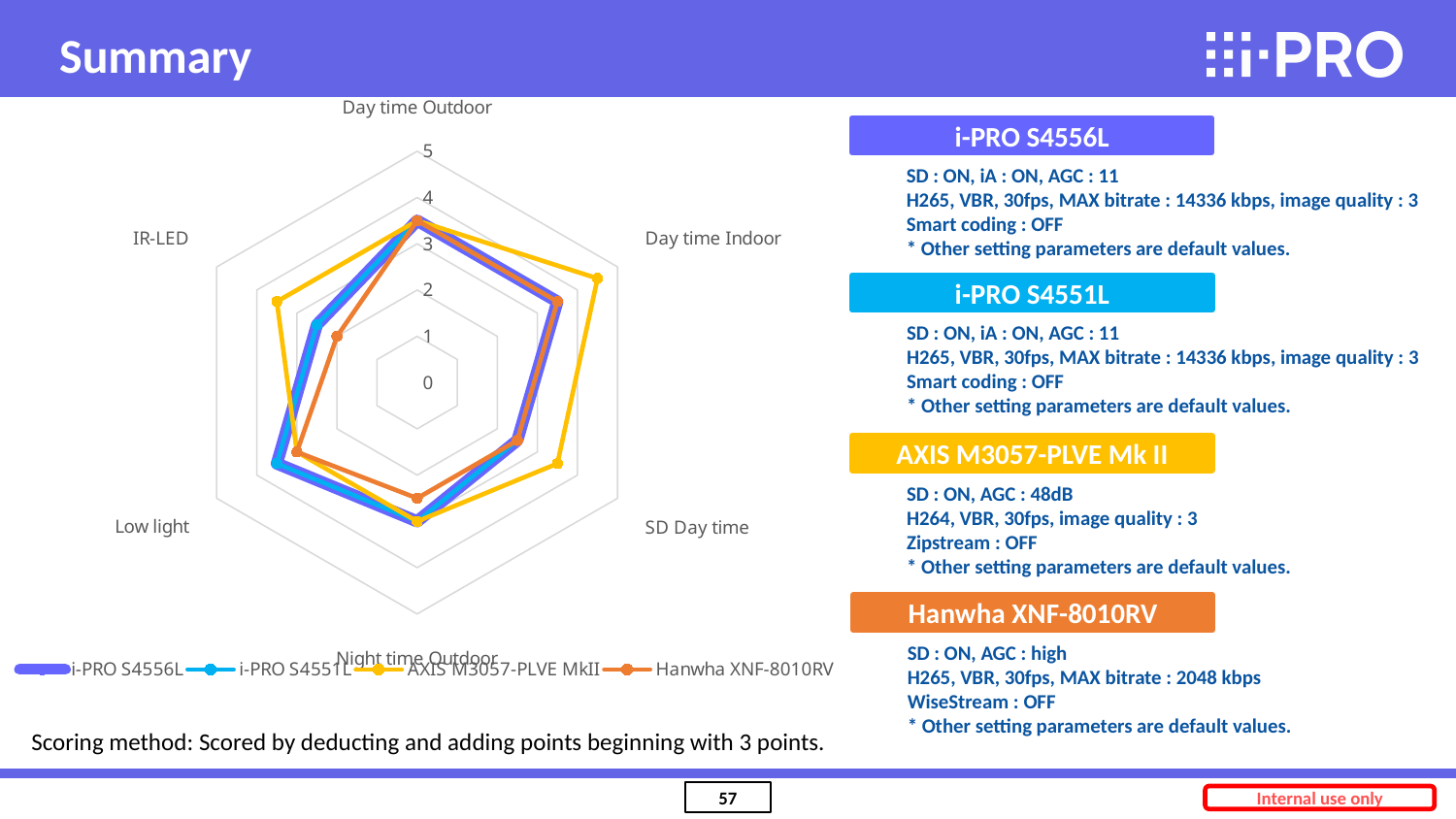
Is the value for AXIS M3057-PLVE MkII on Low light greater or less than 4? less Which colour represents AXIS M3057-PLVE MkII in the radar chart legend? Yellow On the IR-LED axis, which has the larger value: AXIS M3057-PLVE MkII or Hanwha XNF-8010RV? AXIS M3057-PLVE MkII How many series does the legend of the radar chart list? 4 How many categories (axes) does the radar chart have? 6 What is the highest value shown on the radar chart's scale? 5 Is the value for Hanwha XNF-8010RV on Night time Outdoor greater or less than 4? less Is the value for i-PRO S4556L on Low light greater or less than 3? greater What kind of chart is shown on the slide? Radar chart On the Low light axis, which has the larger value: i-PRO S4556L or AXIS M3057-PLVE MkII? i-PRO S4556L